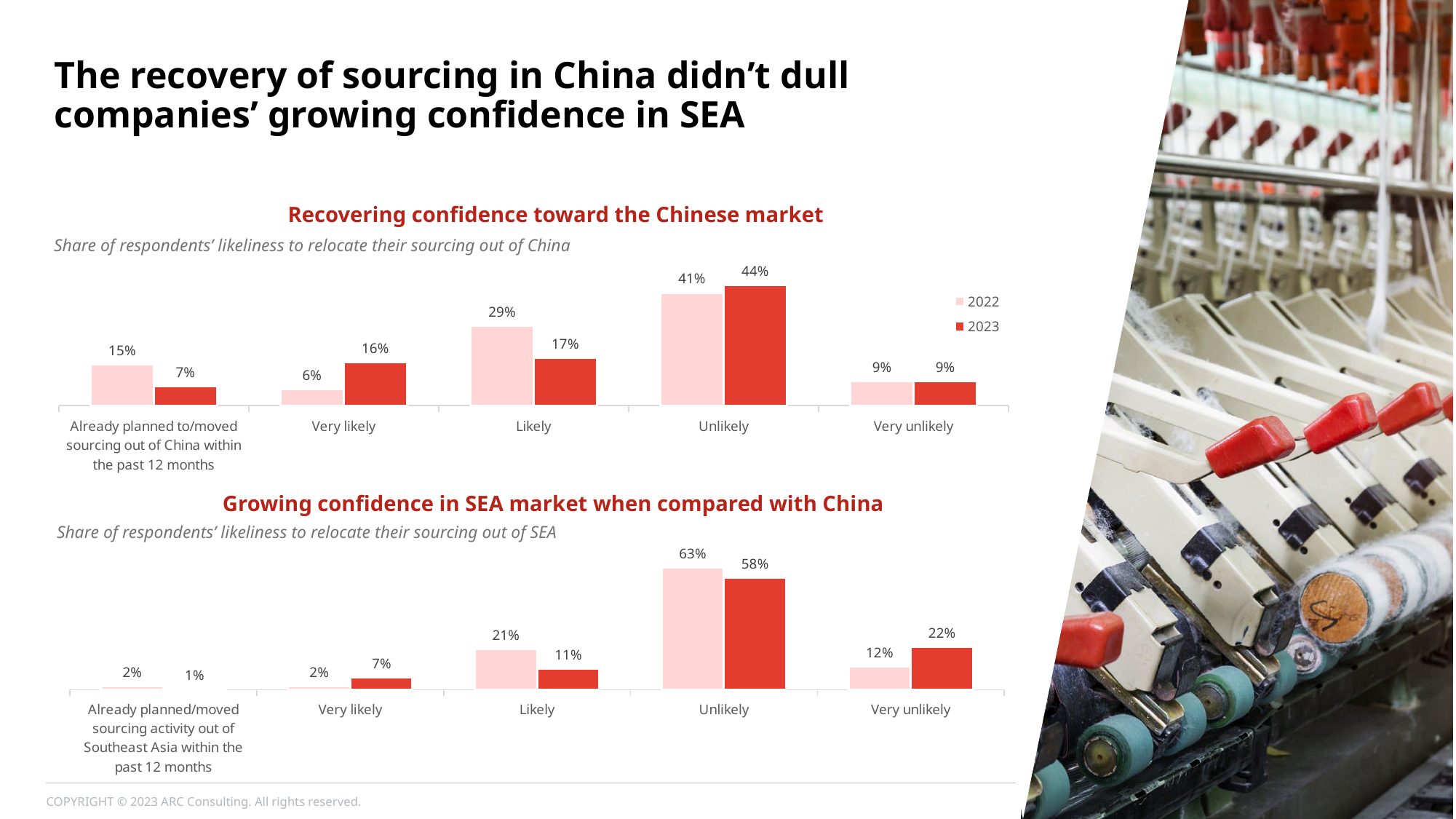
In the 'Growing confidence in SEA market when compared with China' chart, which category has the lowest 2023 value? Already planned/moved sourcing activity out of Southeast Asia within the past 12 months How many series does the legend of the 'Recovering confidence toward the Chinese market' chart list? 2 In the 'Recovering confidence toward the Chinese market' chart, what is the 2022 value for 'Already planned to/moved sourcing out of China within the past 12 months'? 15% In the 'Growing confidence in SEA market when compared with China' chart, what is the 2022 value for 'Unlikely'? 63% In the 'Recovering confidence toward the Chinese market' chart, what is the 2023 value for 'Likely'? 17% In the 'Recovering confidence toward the Chinese market' chart, which category has the highest 2023 value? Unlikely In the 'Recovering confidence toward the Chinese market' chart, what is the difference between the 2022 and 2023 values for 'Very likely'? 10 percentage points What type of chart is the 'Recovering confidence toward the Chinese market' chart? Bar chart In the 'Growing confidence in SEA market when compared with China' chart, what is the difference between the 2022 and 2023 values for 'Unlikely'? 5 percentage points In the 'Recovering confidence toward the Chinese market' chart, which is larger for 'Likely': the 2022 value or the 2023 value? 2022 How many categories are shown on the x axis of the 'Growing confidence in SEA market when compared with China' chart? 5 In the 'Growing confidence in SEA market when compared with China' chart, what is the 2023 value for 'Very unlikely'? 22%